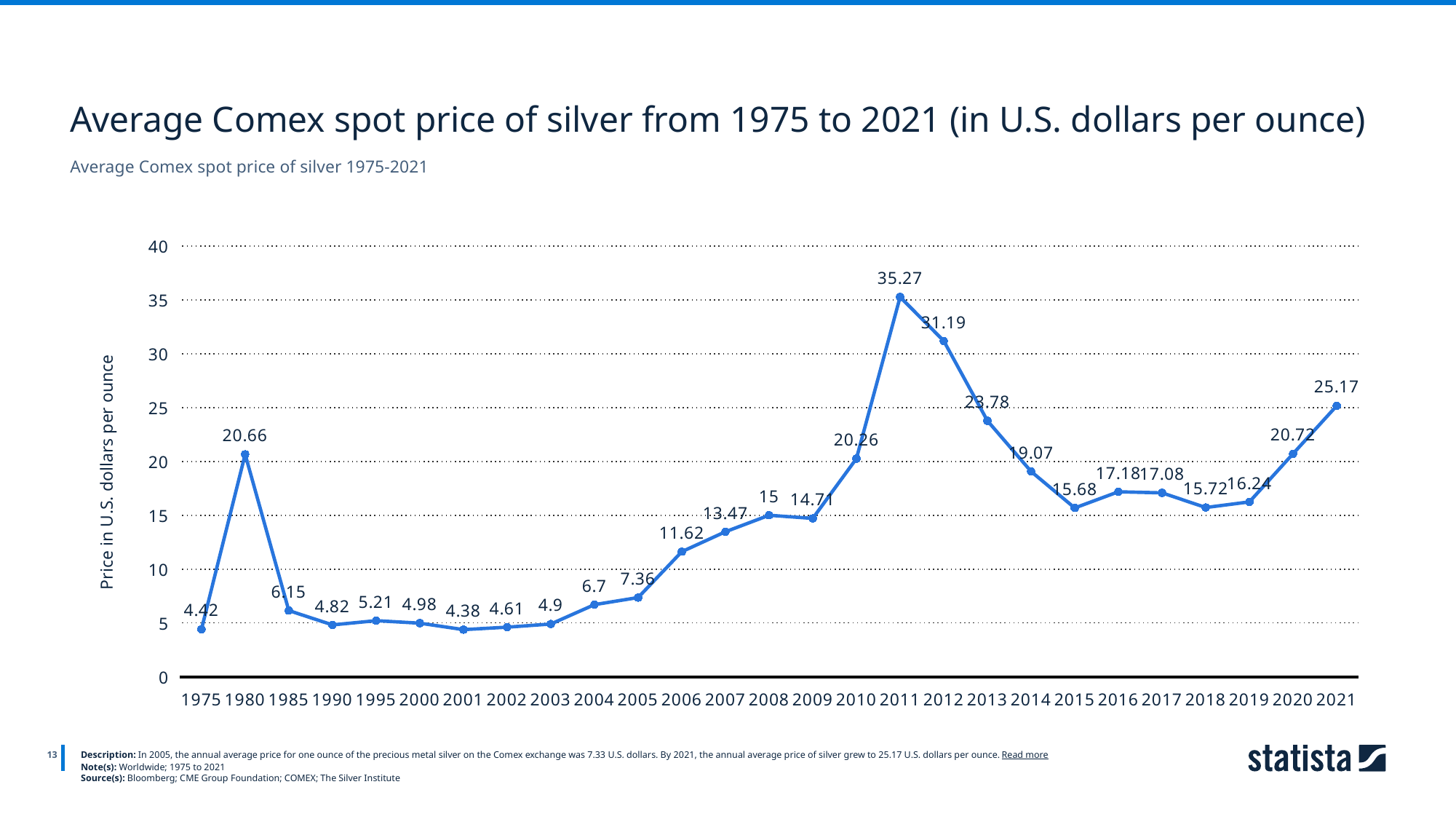
What is the difference between the silver price in 2011 and in 2012? 4.08 How many years are plotted on the chart? 27 What was the average Comex spot price of silver in 2011? 35.27 What kind of chart is shown on the slide? Line chart What was the average Comex spot price of silver in 1980? 20.66 Which year has the highest average Comex spot price of silver? 2011 What was the average Comex spot price of silver in 2021? 25.17 Is the value for 2010 greater or less than 25? less What is the difference between the silver price in 2021 and in 2020? 4.45 Which year has the lowest average Comex spot price of silver? 2001 Which year had a higher average silver price, 2013 or 2014? 2013 What is the label of the y axis? Price in U.S. dollars per ounce